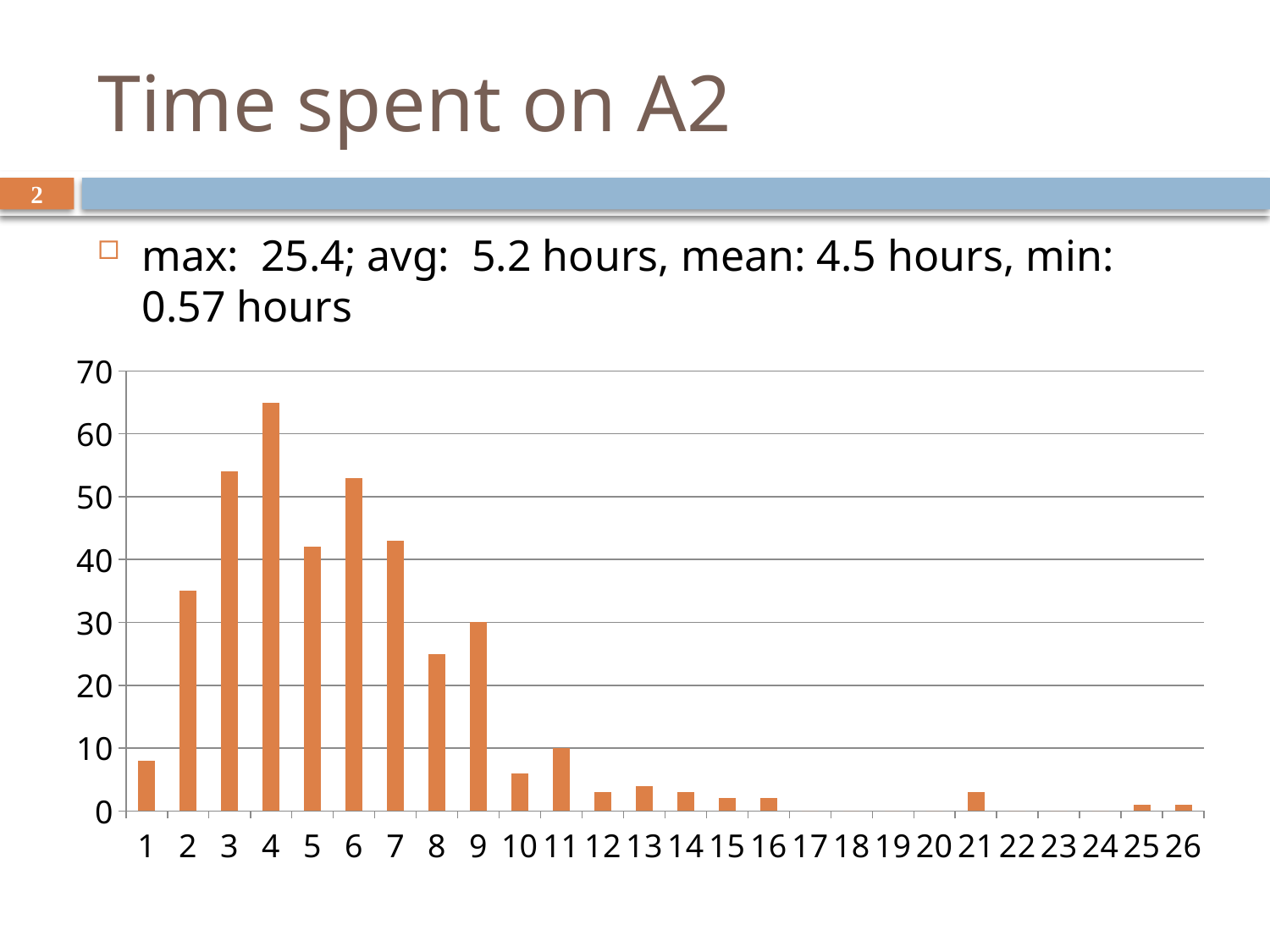
Which is larger, the value for category 8 or the value for category 9? 9 Is the value for category 4 greater or less than 60? greater Which category has the highest bar in the chart? 4 Do the values rise or fall along the x axis from category 4 to category 10? fall Is the value for category 2 greater or less than 30? greater What kind of chart is shown on the slide? bar chart Which is larger, the value for category 2 or the value for category 5? 5 Is the value for category 8 greater or less than 30? less How many categories are shown on the x axis of the chart? 26 What is the title of the slide containing the chart? Time spent on A2